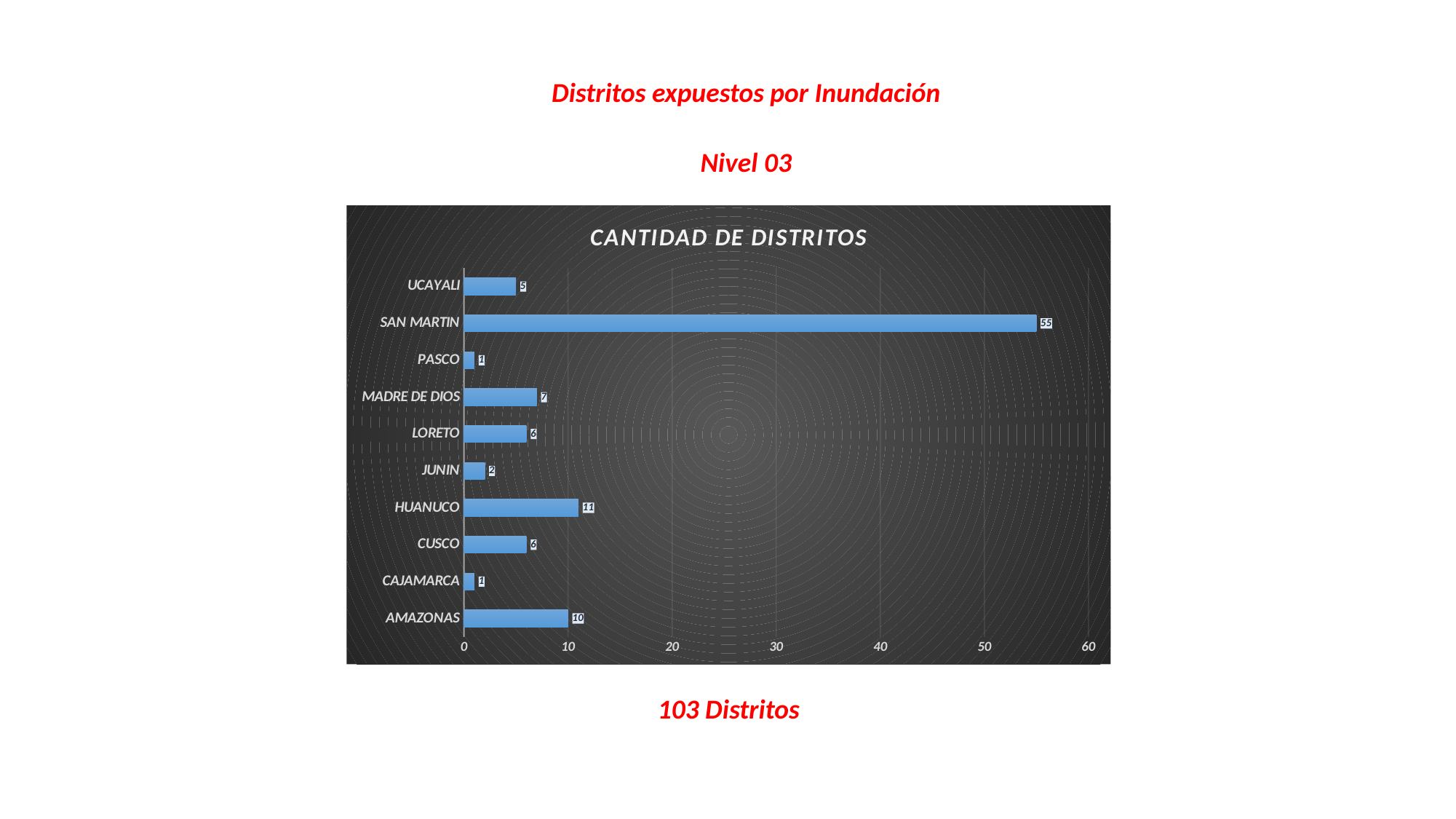
Is the value for SAN MARTIN greater or less than 50? greater What is the value for HUANUCO? 11 Which category has the highest value? SAN MARTIN What is the value for SAN MARTIN? 55 What kind of chart is shown on the slide? bar chart Which is larger, the value for UCAYALI or the value for LORETO? LORETO What is the value for MADRE DE DIOS? 7 What is the difference between the values for SAN MARTIN and HUANUCO? 44 What is the value for AMAZONAS? 10 What is the title of the chart? CANTIDAD DE DISTRITOS What is the difference between the values for AMAZONAS and JUNIN? 8 How many categories are shown in the chart? 10